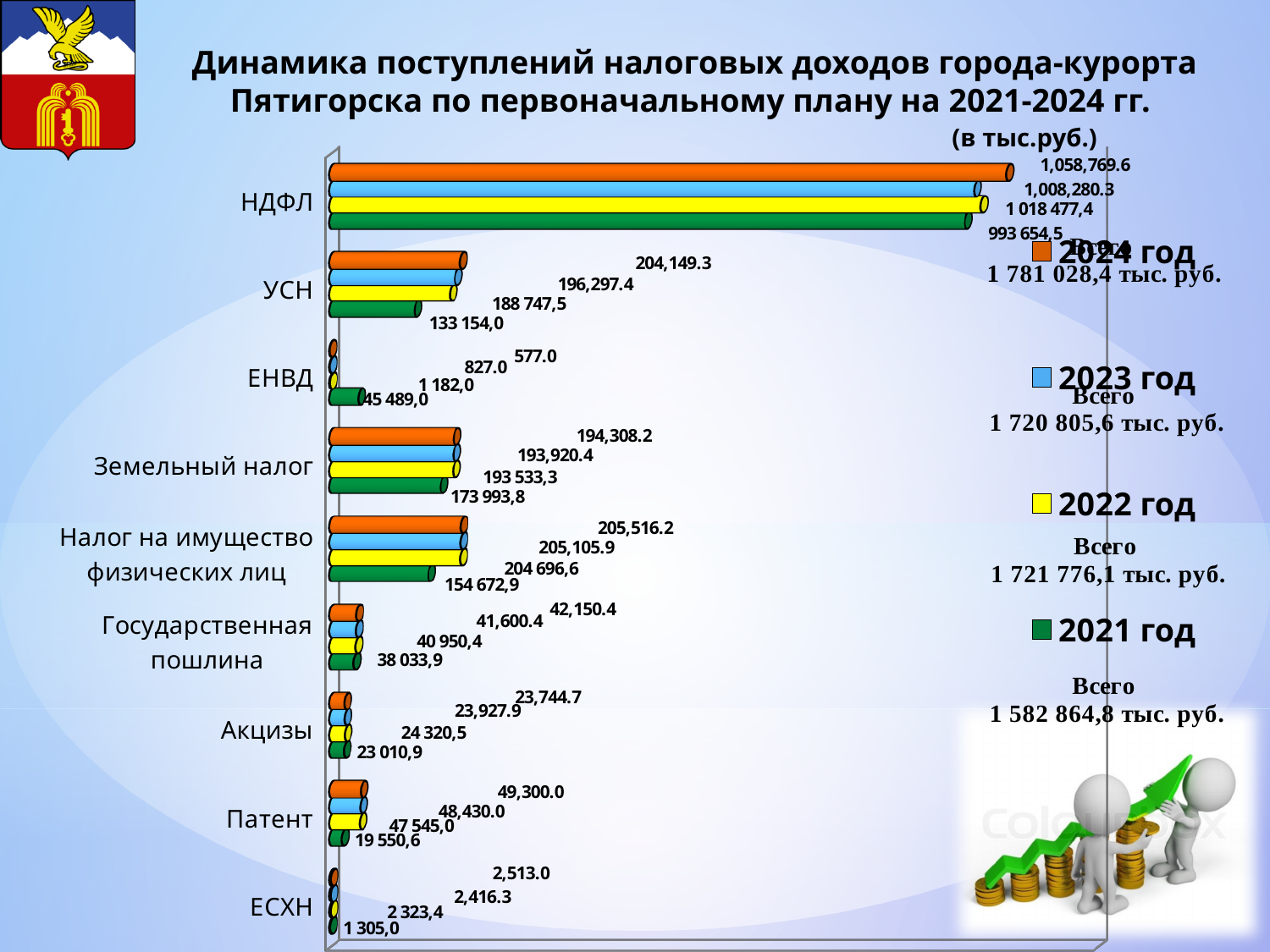
What colour represents the 2021 series in the legend? green For Патент, do the values rise or fall from 2021 to 2024? rise What is the difference between the 2024 and 2023 values for Государственная пошлина? 550.0 For Акцизы, which is larger: the 2022 value or the 2024 value? 2022 Which category has the highest value for 2024? НДФЛ How many series (years) does the legend list? 4 What is the value for НДФЛ in 2024 (orange bar)? 1,058,769.6 What is the value for Патент in 2021 (green bar)? 19 550,6 What is the total (Всего) shown for 2022? 1 721 776,1 тыс. руб. Which category has the lowest value for 2021? ЕСХН What type of chart is shown on the slide? bar chart How many tax categories are plotted on the chart? 9